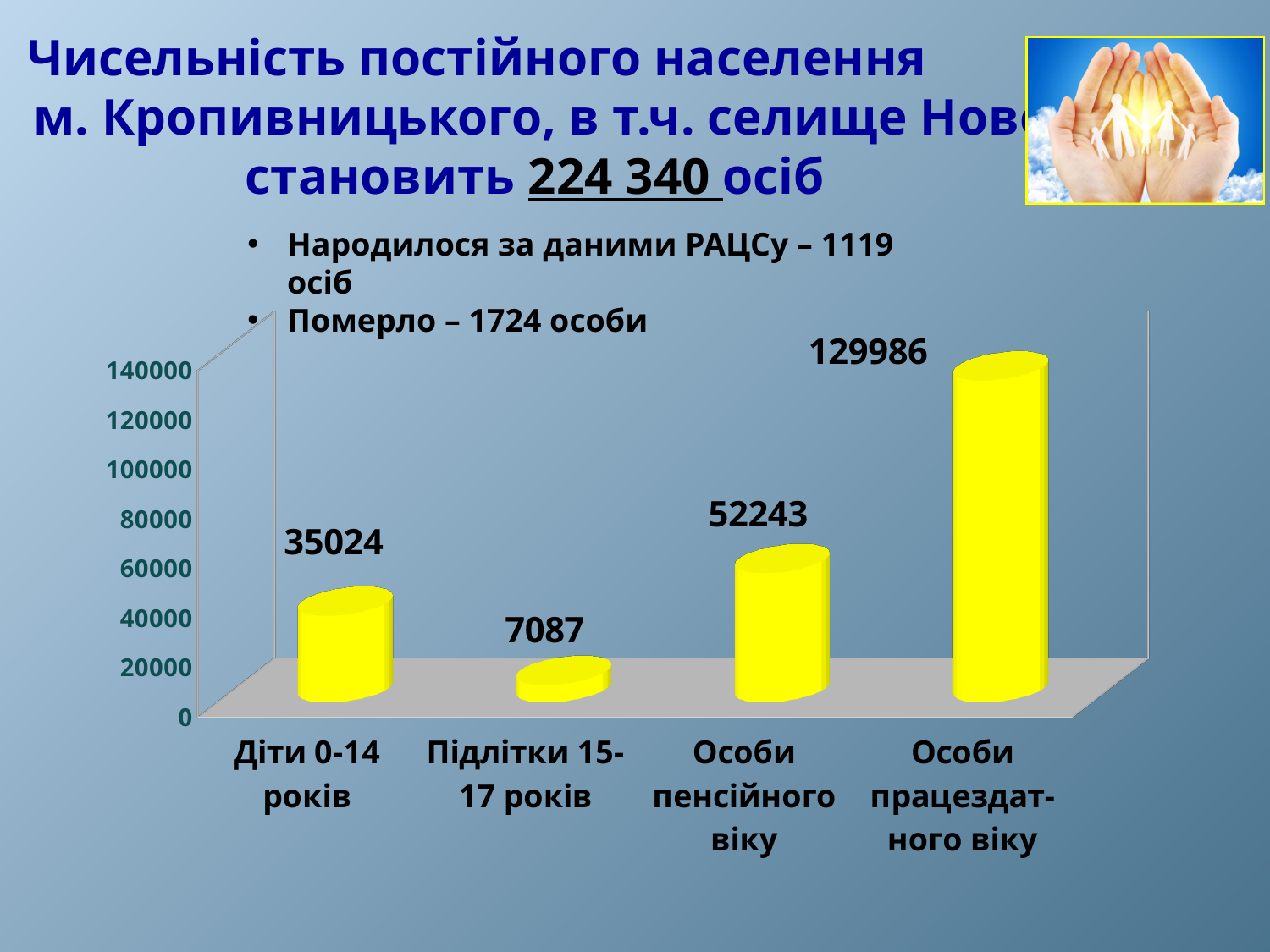
What is the value for Особи працездатного віку? 129986 What is the value for Підлітки 15-17 років? 7087 Is the value for Особи працездатного віку greater or less than 120000? greater What kind of chart is shown on the slide? bar chart Which category has the highest value? Особи працездатного віку Which category has the lowest value? Підлітки 15-17 років What is the value for Особи пенсійного віку? 52243 What is the value for Діти 0-14 років? 35024 What is the difference between the values for Особи пенсійного віку and Діти 0-14 років? 17219 How many categories are shown in the chart? 4 What is the difference between the values for Особи працездатного віку and Особи пенсійного віку? 77743 Which is larger, the value for Діти 0-14 років or the value for Особи пенсійного віку? Особи пенсійного віку